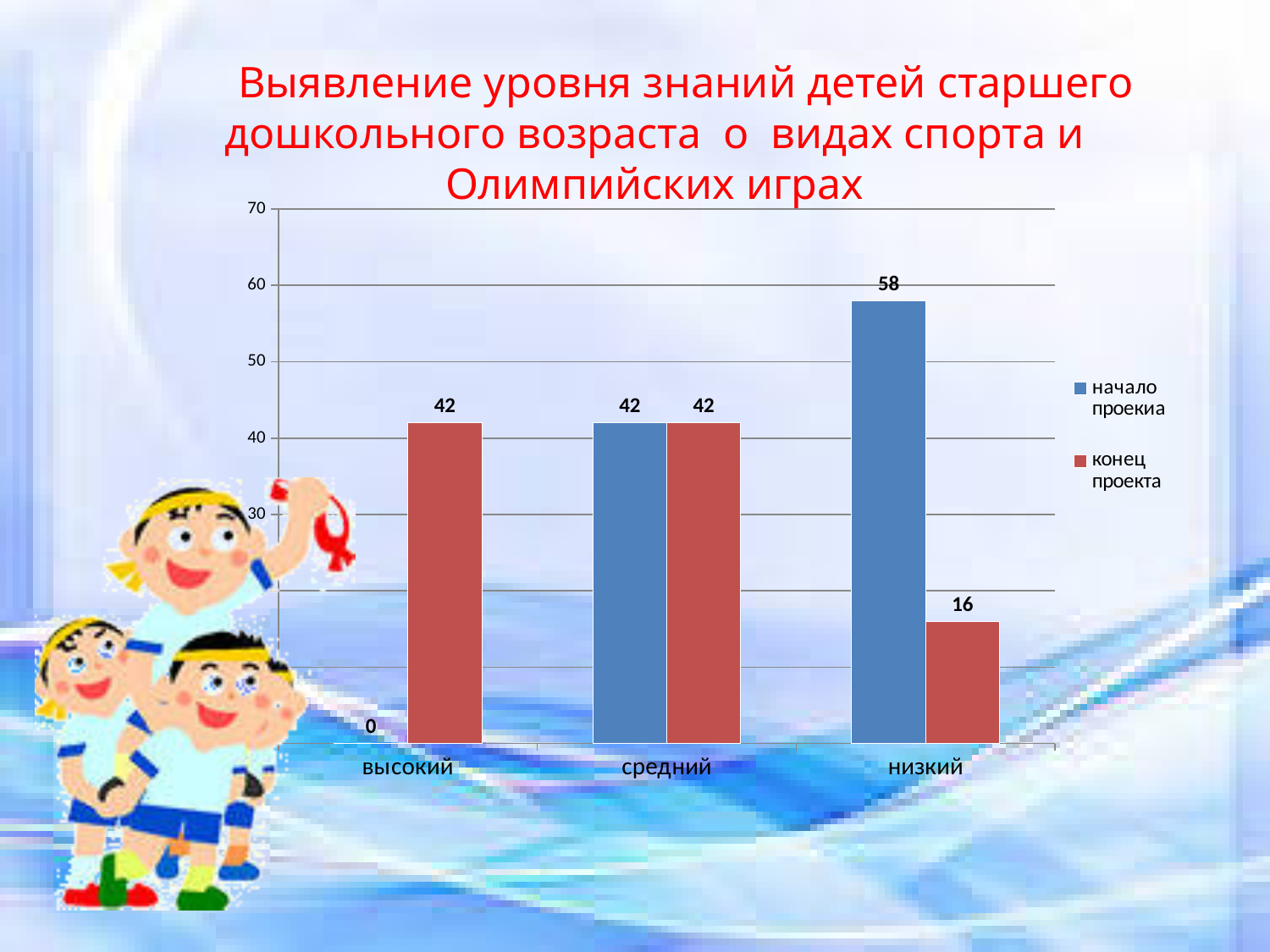
What kind of chart is shown on the slide? bar chart What is the difference between the 'начало проекиа' and 'конец проекта' values for 'низкий'? 42 What is the value for 'высокий' in the 'конец проекта' series? 42 What is the value for 'высокий' in the 'начало проекиа' series? 0 What is the value for 'низкий' in the 'начало проекиа' series? 58 Which category has the lowest value in the 'конец проекта' series? низкий How many series does the legend list? 2 Which is larger for 'высокий': the 'начало проекиа' value or the 'конец проекта' value? конец проекта Which category has the highest value in the 'начало проекиа' series? низкий Which colour represents the 'конец проекта' series? red What is the value for 'низкий' in the 'конец проекта' series? 16 How many categories are shown on the x axis? 3